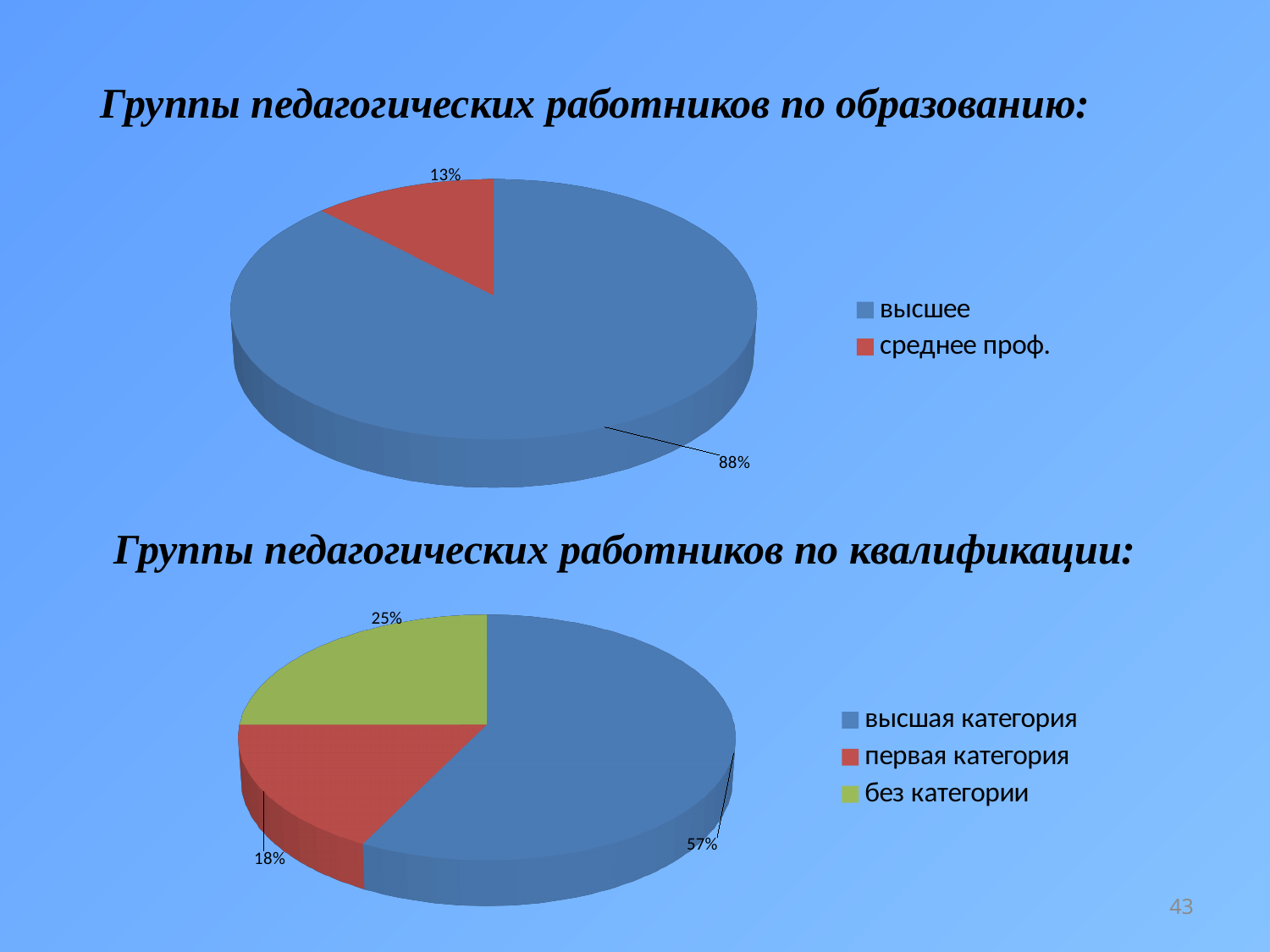
In the bottom chart (Группы педагогических работников по квалификации), how many categories does the legend list? 3 In the bottom chart (Группы педагогических работников по квалификации), what is the difference in percentage points between высшая категория and без категории? 32 In the top chart (Группы педагогических работников по образованию), which category has the largest slice? высшее In the bottom chart (Группы педагогических работников по квалификации), which is larger: без категории or первая категория? без категории In the top chart (Группы педагогических работников по образованию), what share is labelled for высшее? 88% In the top chart (Группы педагогических работников по образованию), how many categories does the legend list? 2 What kind of chart is the top chart (Группы педагогических работников по образованию)? pie chart In the top chart (Группы педагогических работников по образованию), what share is labelled for среднее проф.? 13% In the bottom chart (Группы педагогических работников по квалификации), what share is labelled for без категории? 25% In the bottom chart (Группы педагогических работников по квалификации), what share is labelled for высшая категория? 57% In the bottom chart (Группы педагогических работников по квалификации), which category has the smallest slice? первая категория In the bottom chart (Группы педагогических работников по квалификации), what share is labelled for первая категория? 18%